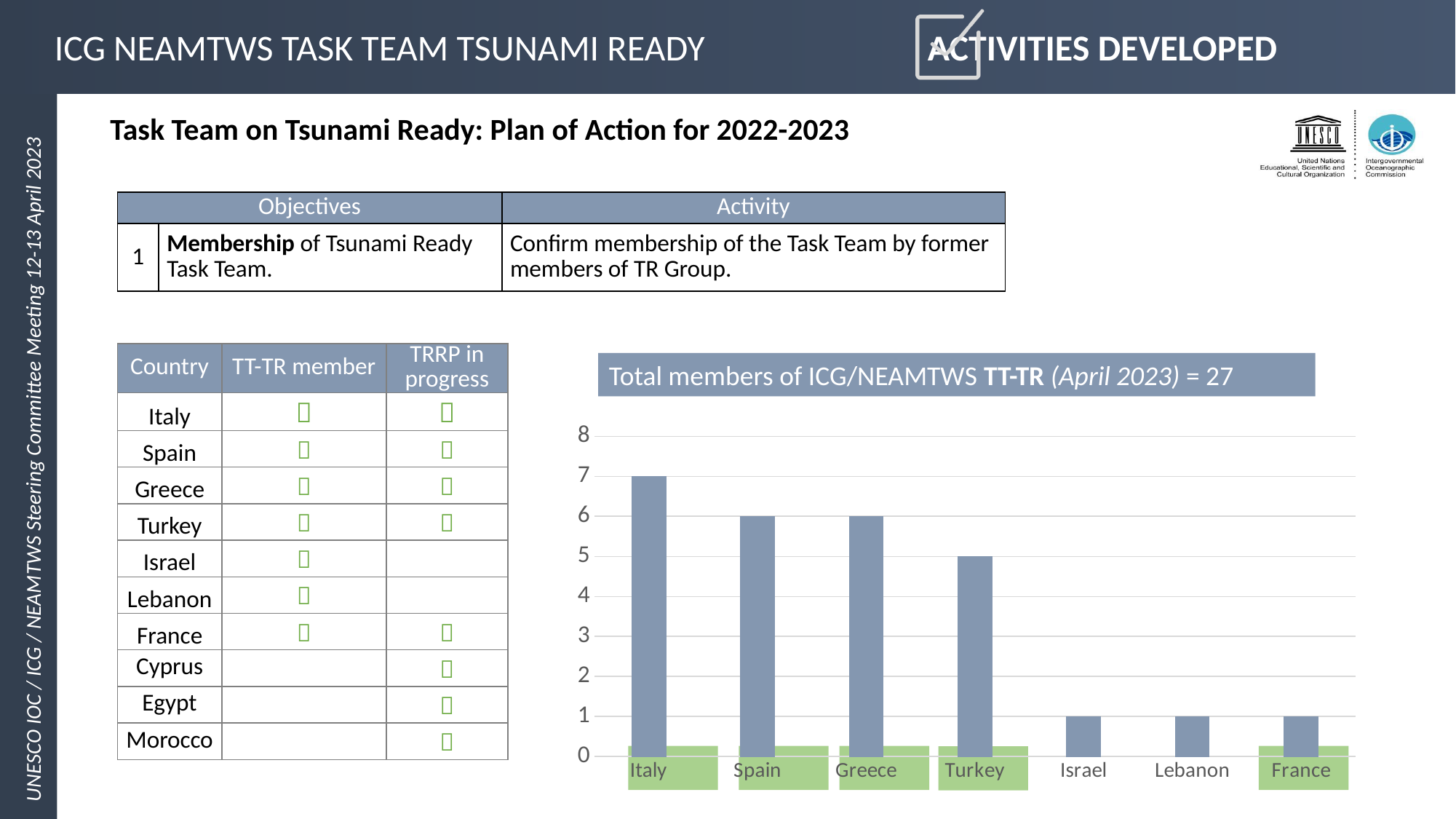
According to the chart title, what is the total number of members of ICG/NEAMTWS TT-TR in April 2023? 27 What kind of chart is shown on the slide? bar chart What is the value for Turkey in the chart? 5 What is the difference between the values for Italy and Turkey? 2 What is the value for Italy in the chart? 7 What is the value for Spain in the chart? 6 Is the value for Italy greater or less than 4? greater Which country has the highest bar in the chart? Italy Which has a larger value, Greece or Israel? Greece What is the value for Lebanon in the chart? 1 How many countries are shown on the x axis of the chart? 7 Do the bar values generally rise or fall from left to right along the x axis? fall